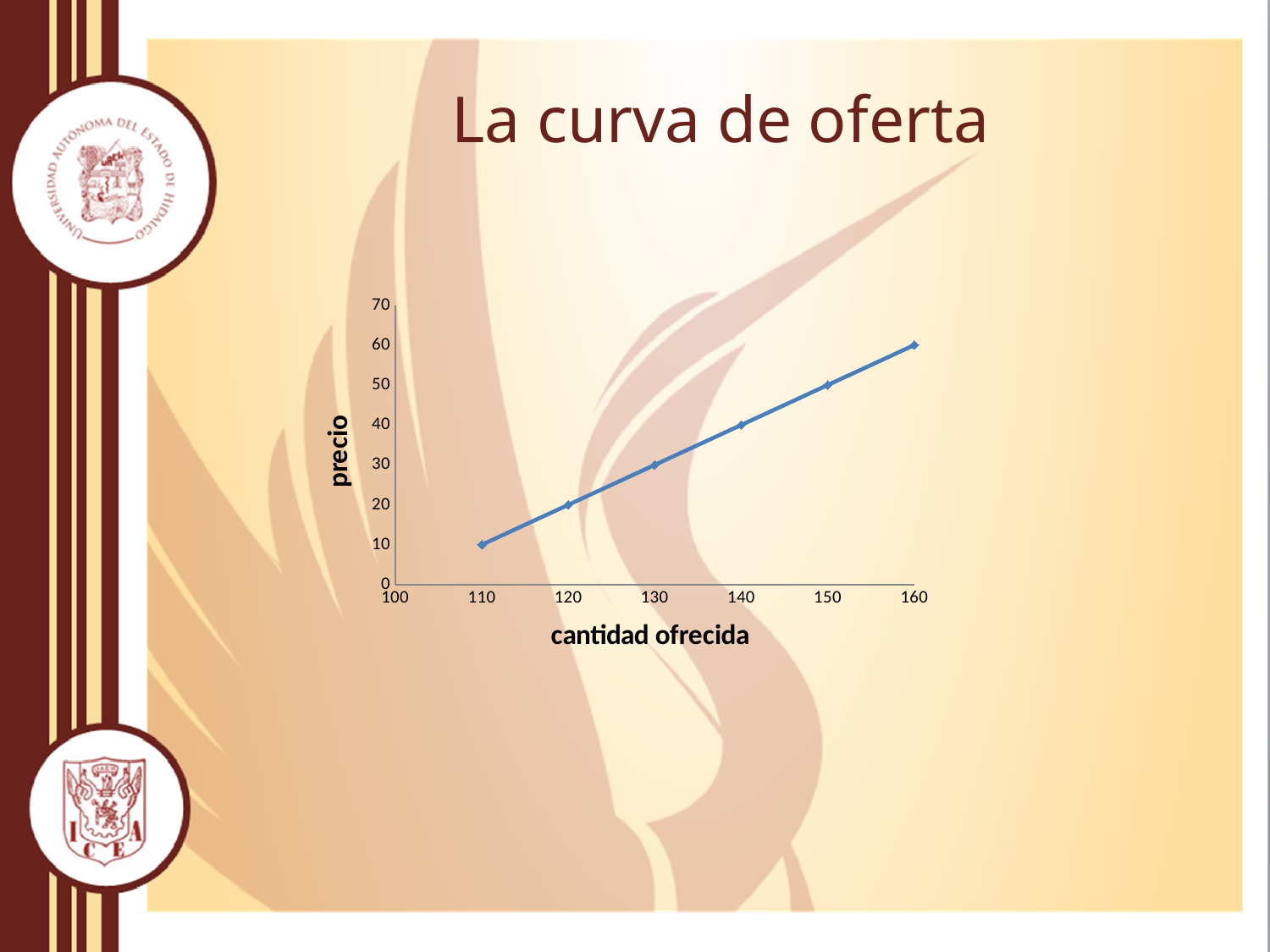
What is the title of the slide containing the chart? La curva de oferta Which has a higher precio: cantidad ofrecida 140 or cantidad ofrecida 120? 140 What is the label of the x axis? cantidad ofrecida What is the precio when cantidad ofrecida is 130? 30 What is the precio when cantidad ofrecida is 160? 60 How many data points are plotted on the line? 6 What is the precio when cantidad ofrecida is 110? 10 At which cantidad ofrecida is the precio highest? 160 What is the difference in precio between cantidad ofrecida 150 and cantidad ofrecida 120? 30 At which cantidad ofrecida is the precio lowest? 110 Does the precio rise or fall as cantidad ofrecida increases along the x axis? rise What kind of chart is shown on the slide? line chart